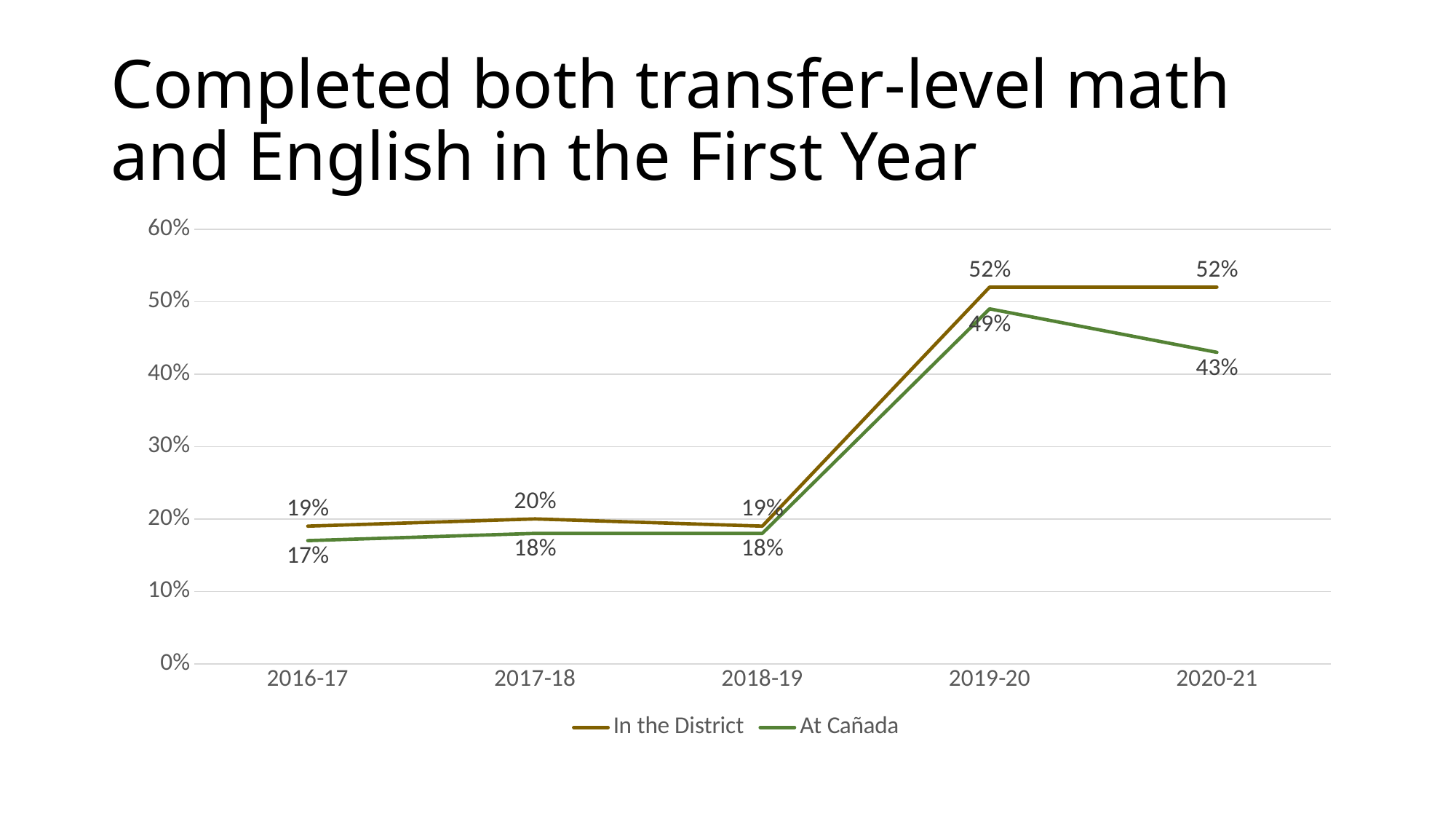
In which year is the At Cañada value lowest? 2016-17 How many series does the legend list? 2 Which is larger in 2019-20, In the District or At Cañada? In the District How many years are shown on the x axis? 5 What kind of chart is shown? line chart In which year is the At Cañada value highest? 2019-20 What is the value for In the District in 2019-20? 52% What is the difference between In the District and At Cañada in 2020-21? 9% What is the value for In the District in 2017-18? 20% What is the value for At Cañada in 2020-21? 43% What is the value for At Cañada in 2016-17? 17% Does the At Cañada value rise or fall from 2019-20 to 2020-21? fall